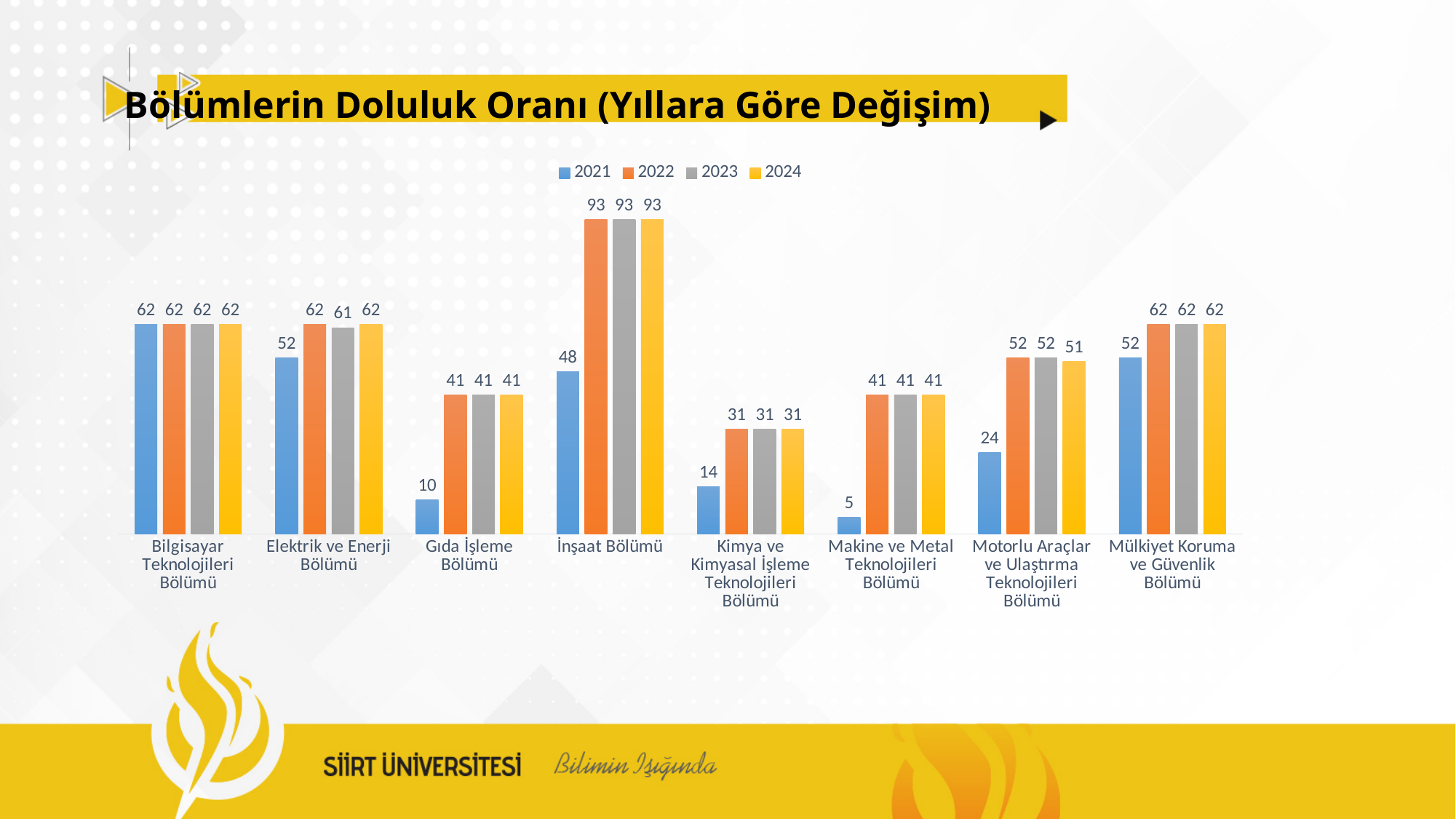
What is the 2021 value for Gıda İşleme Bölümü? 10 What kind of chart is shown on the slide? bar chart What is the title of the chart? Bölümlerin Doluluk Oranı (Yıllara Göre Değişim) Which department has the lowest 2021 value? Makine ve Metal Teknolojileri Bölümü What is the difference between the 2022 and 2021 values for İnşaat Bölümü? 45 How many departments are shown on the x axis? 8 Which is larger: the 2021 value for Kimya ve Kimyasal İşleme Teknolojileri Bölümü or the 2021 value for Motorlu Araçlar ve Ulaştırma Teknolojileri Bölümü? Motorlu Araçlar ve Ulaştırma Teknolojileri Bölümü How many series does the legend list? 4 What is the 2024 value for Motorlu Araçlar ve Ulaştırma Teknolojileri Bölümü? 51 Which colour represents the 2023 series in the legend? grey What is the 2023 value for Elektrik ve Enerji Bölümü? 61 Which department has the highest 2022 value? İnşaat Bölümü